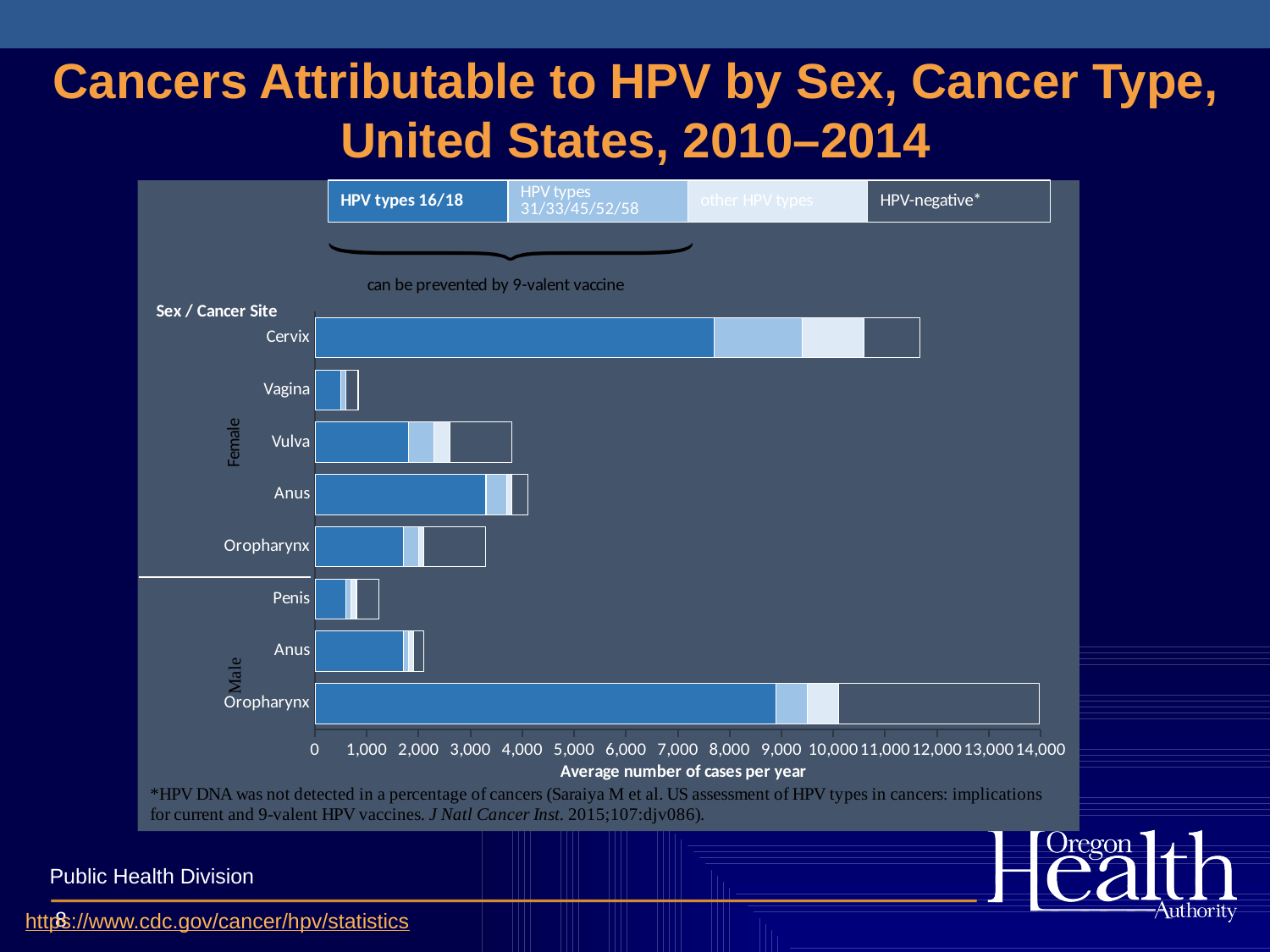
Is the total bar for Male Oropharynx greater or less than 13,000? greater Is the total bar for Vagina greater or less than 1,000? less Which cancer site has the shortest bar (lowest average number of cases per year)? Vagina How many series does the legend list? 4 Which bar is longer, Female Anus or Male Anus? Female Anus Which cancer site has the longest bar (highest average number of cases per year)? Oropharynx (Male) Is the total bar for Cervix greater or less than 10,000? greater What is the title of the x axis? Average number of cases per year What kind of chart is shown on the slide? bar chart Which bar is longer, Cervix or Male Oropharynx? Male Oropharynx How many cancer site bars are plotted in the chart? 8